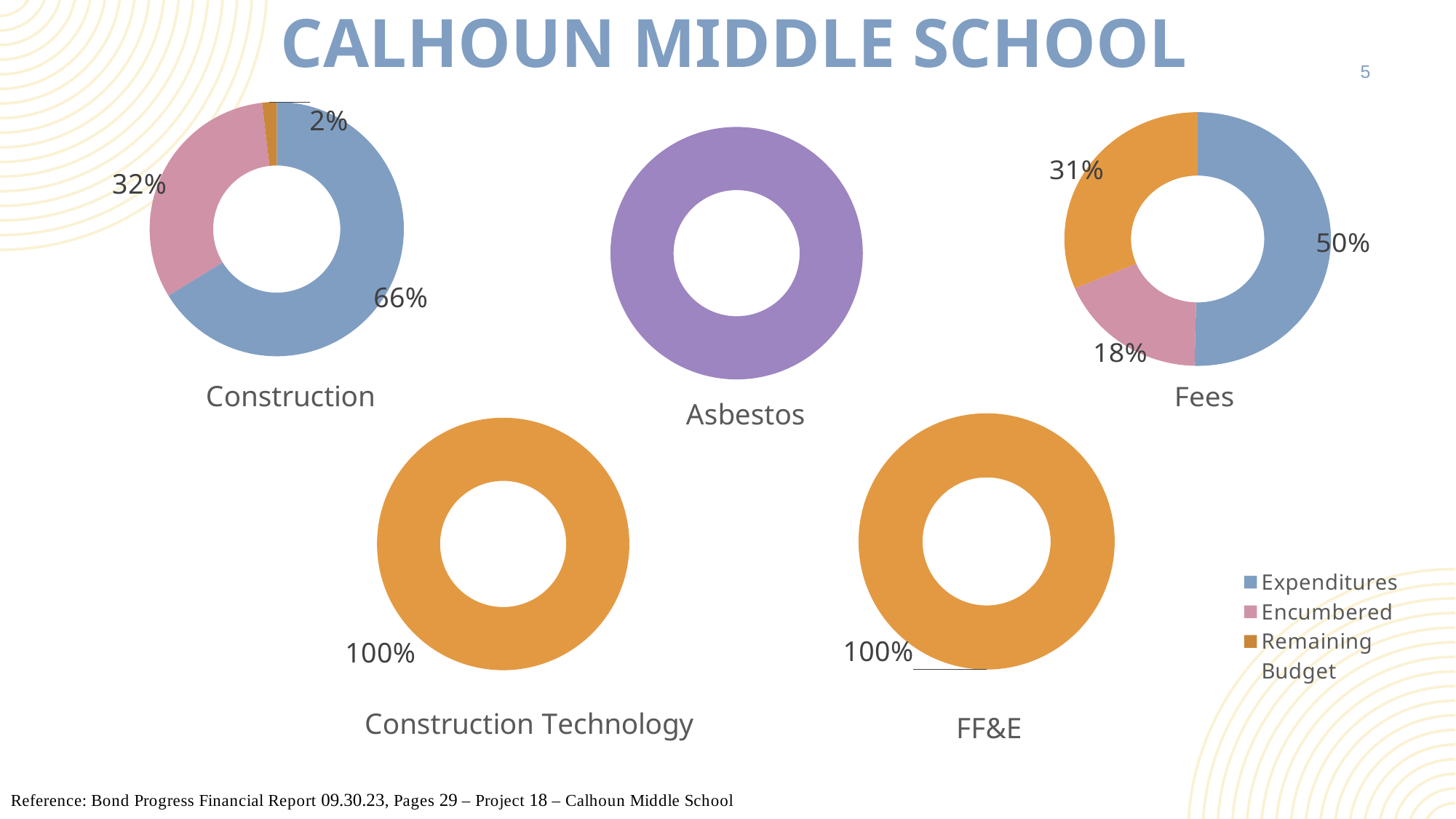
In the Fees chart, which category has the smallest share? Encumbered In the Construction Technology chart, what share is Remaining Budget? 100% In the Fees chart, what share is Encumbered? 18% In the Construction chart, what share is Expenditures? 66% How many series does the legend list? 3 In the Construction chart, what share is Encumbered? 32% In the Fees chart, what share is Expenditures? 50% In the Construction chart, which category has the largest share? Expenditures In the Construction chart, what share is Remaining Budget? 2% Is the Expenditures share larger in the Construction chart or the Fees chart? Construction In the Fees chart, what share is Remaining Budget? 31% In the Construction chart, what is the difference between the Expenditures share and the Encumbered share? 34%